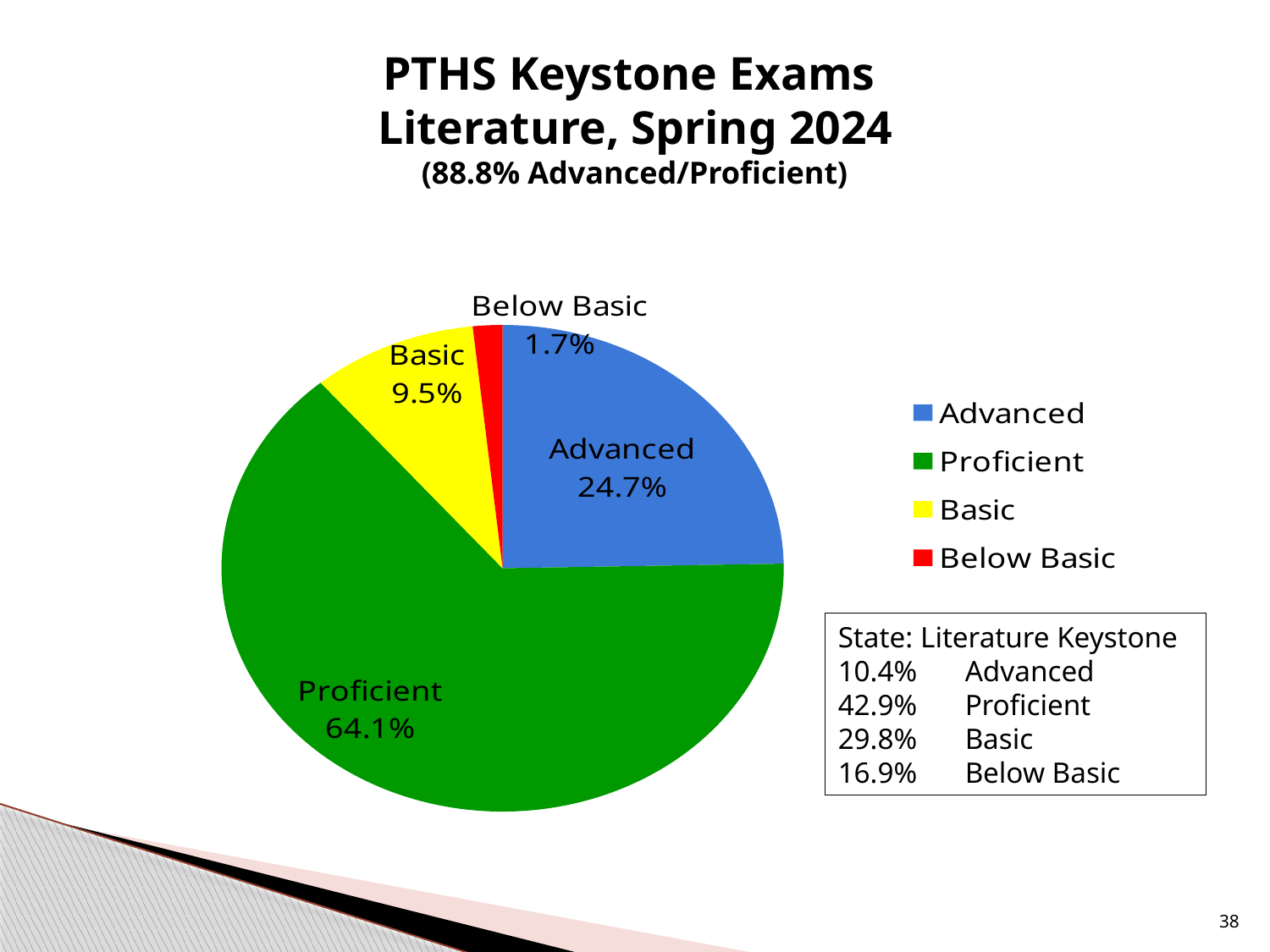
How many categories are shown in the pie chart? 4 What percentage of the pie chart is Advanced? 24.7% What percentage of the pie chart is Below Basic? 1.7% What type of chart is shown on the slide? Pie chart Which category has the largest slice of the pie chart? Proficient What percentage of the pie chart is Proficient? 64.1% What colour is the Proficient slice in the pie chart? Green What percentage of the pie chart is Basic? 9.5% What is the difference in percentage points between the Proficient and Advanced slices? 39.4 Which category has the smallest slice of the pie chart? Below Basic What is the combined percentage of the Advanced and Proficient slices? 88.8% Which slice is larger, Basic or Below Basic? Basic